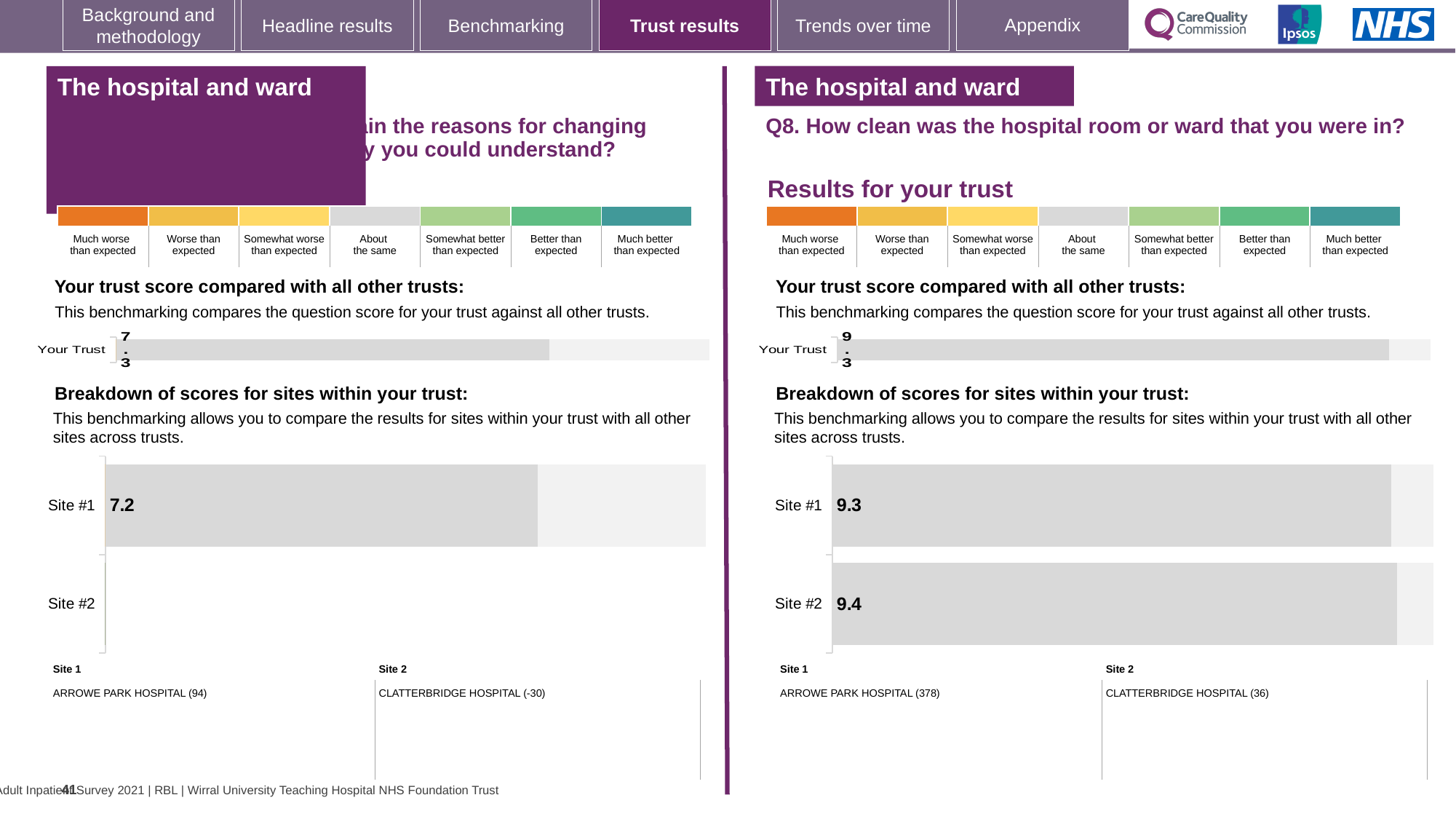
Is the Site #1 score on the Q8 chart larger or smaller than the Site #1 score on the left-hand chart? larger What is the difference between the 'Your Trust' score on the Q8 chart and the 'Your Trust' score on the left-hand chart? 2.0 In the Q8 breakdown of scores for sites within your trust, what is the score for Site #2? 9.4 How many sites are listed in the Q8 breakdown of scores for sites within your trust? 2 On the right-hand Q8 chart, what is the trust score shown for 'Your Trust'? 9.3 In the left-hand breakdown of scores for sites within your trust, what is the score for Site #1? 7.2 In the Q8 site breakdown chart, what is the difference between the Site #2 and Site #1 scores? 0.1 On the left-hand chart, what is the trust score shown for 'Your Trust'? 7.3 In the Q8 site breakdown chart, which site has the higher score? Site #2 Which hospital is listed as Site 1 on the Q8 side of the slide? ARROWE PARK HOSPITAL (378) In the Q8 breakdown of scores for sites within your trust, what is the score for Site #1? 9.3 What type of chart is used to show the breakdown of scores for sites within your trust on the Q8 side? bar chart